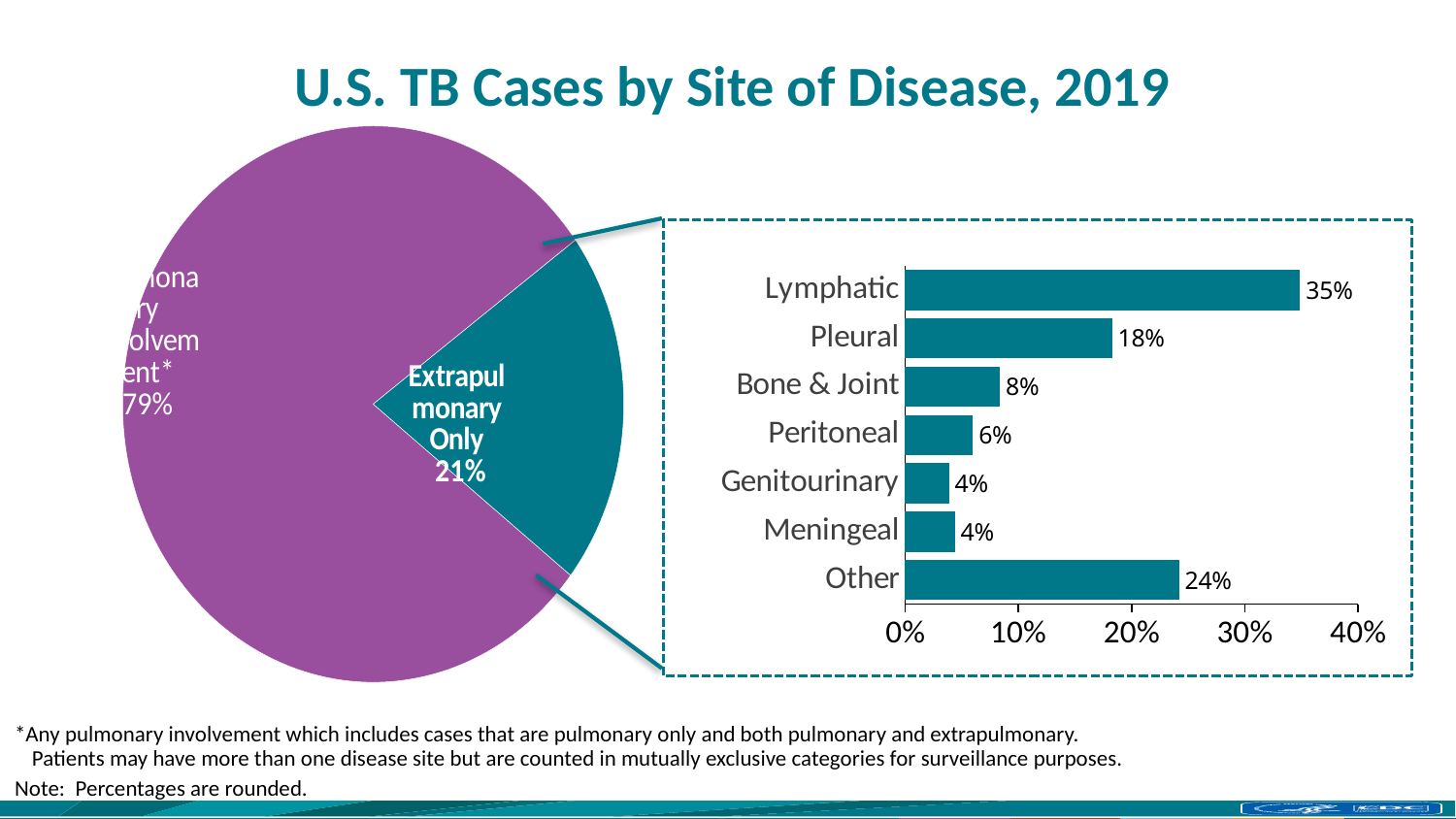
In the bar chart, what is the value for Other? 24% In the bar chart, what is the value for Peritoneal? 6% How many site categories are shown in the bar chart? 7 In the pie chart, what share of cases is Extrapulmonary Only? 21% In the bar chart, which is larger, the value for Other or the value for Pleural? Other In the bar chart, which site of disease has the highest percentage? Lymphatic In the bar chart, what is the value for Pleural? 18% What kind of chart is the chart on the right side of the slide? bar chart What is the title of the slide's chart? U.S. TB Cases by Site of Disease, 2019 In the bar chart, is the value for Lymphatic greater or less than 30%? greater In the bar chart, what percentage of cases is shown for Lymphatic? 35% In the bar chart, what is the difference between the Lymphatic and Pleural values? 17 percentage points